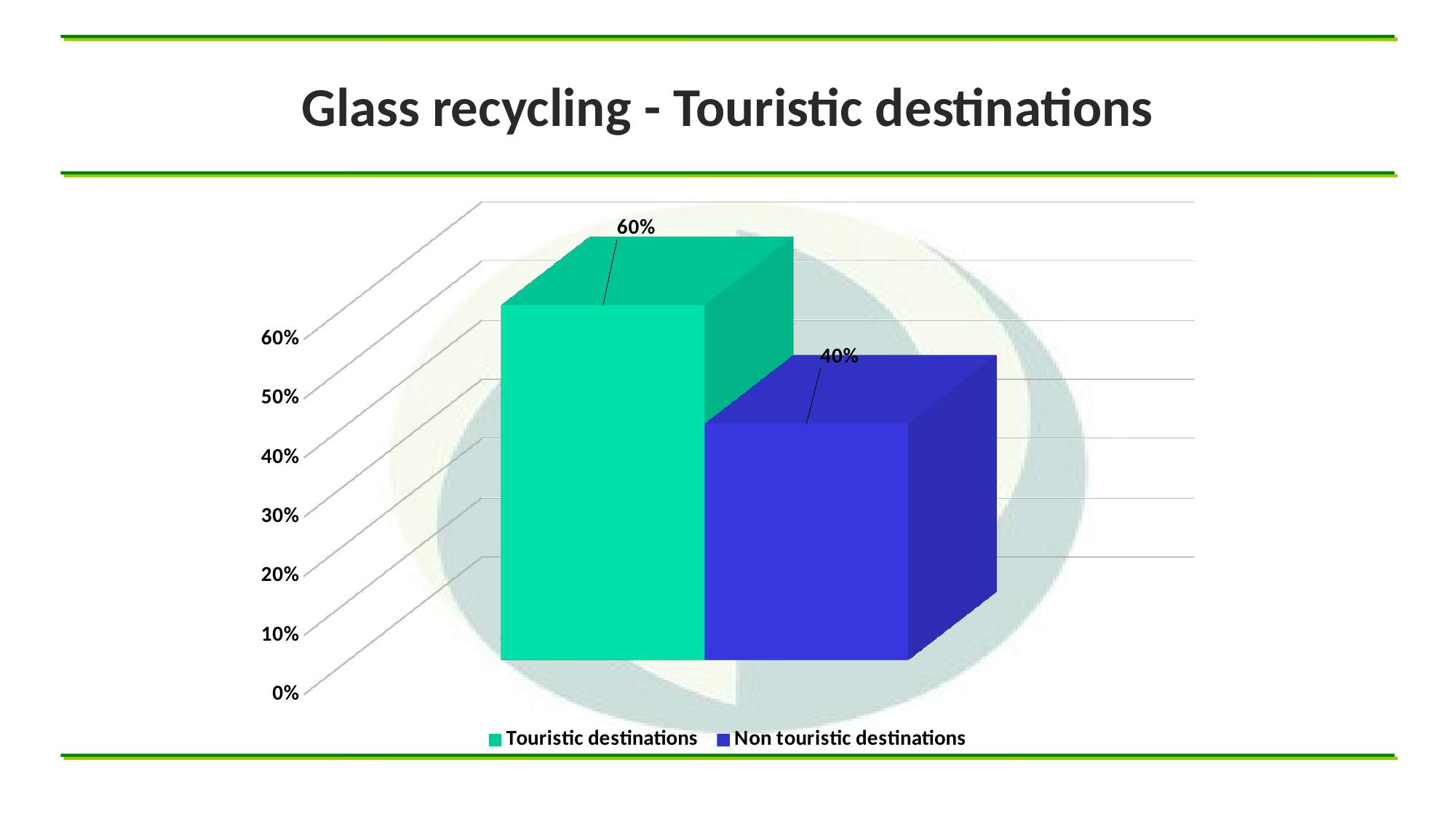
How many entries does the legend list? 2 What is the title of the slide? Glass recycling - Touristic destinations Is the value for Non touristic destinations greater or less than 50%? less Which category has the highest value? Touristic destinations What colour is the bar for Non touristic destinations? Blue What is the value for Touristic destinations? 60% Which is larger, the value for Touristic destinations or Non touristic destinations? Touristic destinations How many bars are plotted on the chart? 2 What is the value for Non touristic destinations? 40% What kind of chart is shown on the slide? Bar chart What is the difference between the values for Touristic destinations and Non touristic destinations? 20% Which category has the lowest value? Non touristic destinations